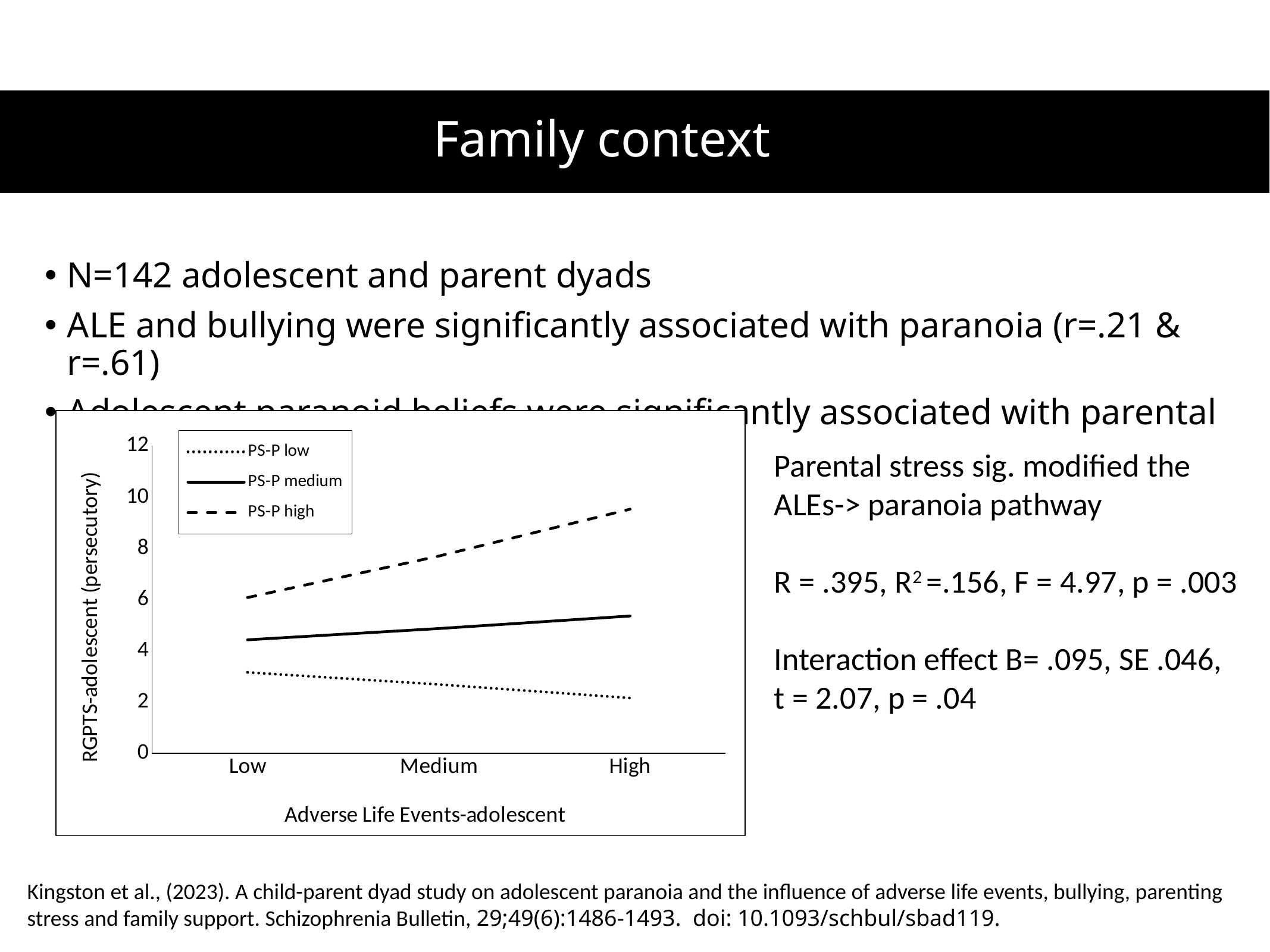
Does the PS-P medium line rise or fall as Adverse Life Events go from Low to High? rise Does the PS-P low line rise or fall as Adverse Life Events go from Low to High? fall How many series does the chart's legend list? 3 Which series has the lowest value at the High Adverse Life Events category? PS-P low What kind of chart is shown on the slide? line chart At the Low Adverse Life Events category, which is larger: the value for PS-P high or the value for PS-P medium? PS-P high What is the label of the chart's y axis? RGPTS-adolescent (persecutory) Does the PS-P high line rise or fall as Adverse Life Events go from Low to High? rise How many categories are shown on the x axis of the chart? 3 Is the value for PS-P high at the High Adverse Life Events category greater or less than 8? greater Is the value for PS-P low at the High Adverse Life Events category greater or less than 4? less Which series has the highest value at the High Adverse Life Events category? PS-P high